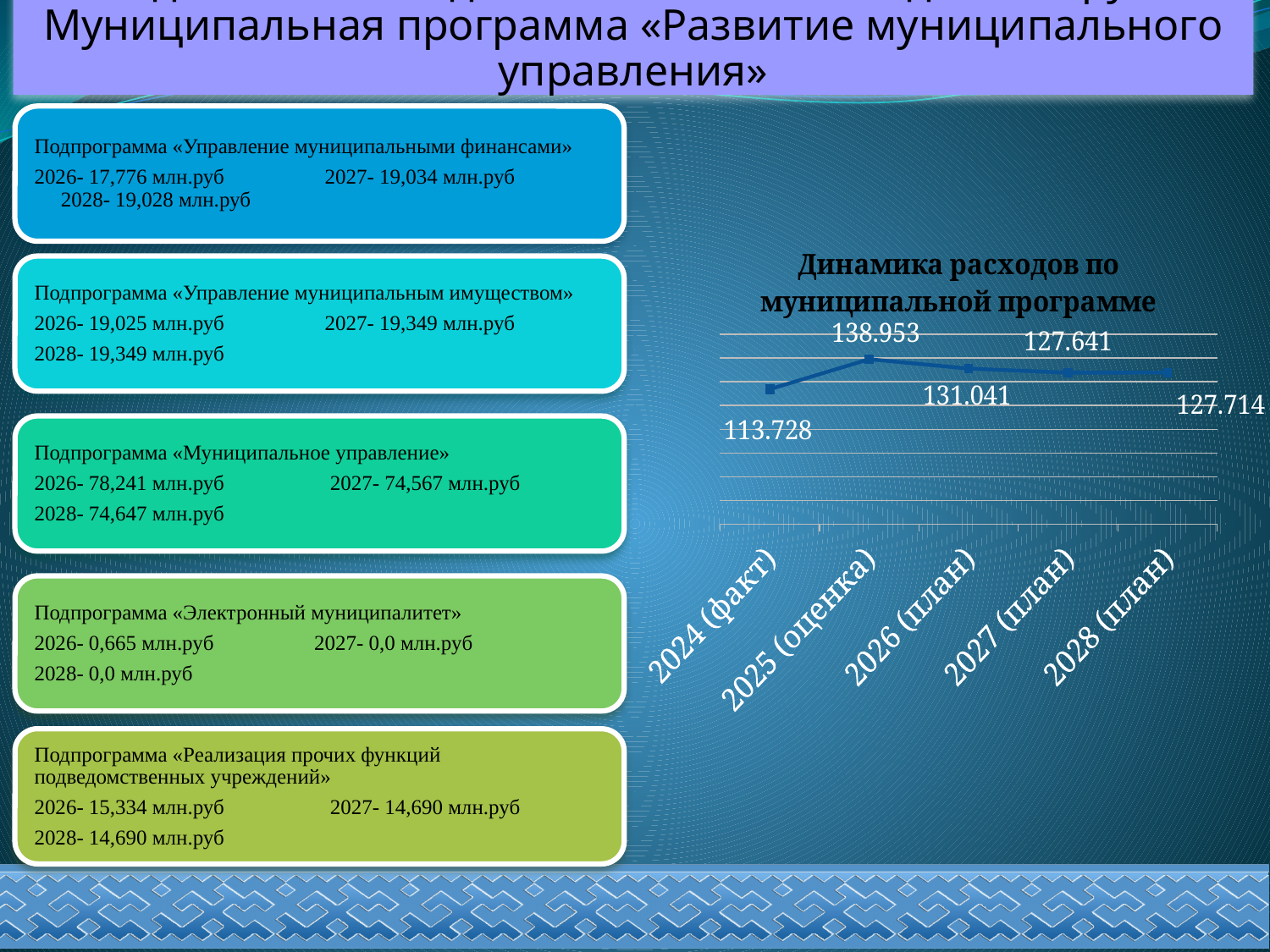
Do the values rise or fall from 2025 (оценка) to 2027 (план)? fall Which year has the lowest value on the chart? 2024 (факт) Which is larger, the value for 2026 (план) or the value for 2027 (план)? 2026 (план) What is the value for 2026 (план)? 131.041 What is the value for 2028 (план)? 127.714 What is the difference between the values for 2025 (оценка) and 2024 (факт)? 25.225 What is the title of the chart? Динамика расходов по муниципальной программе How many data points are plotted on the chart? 5 What is the value for 2025 (оценка)? 138.953 Which year has the highest value on the chart? 2025 (оценка) What is the value for 2024 (факт)? 113.728 What type of chart is shown on the slide? line chart